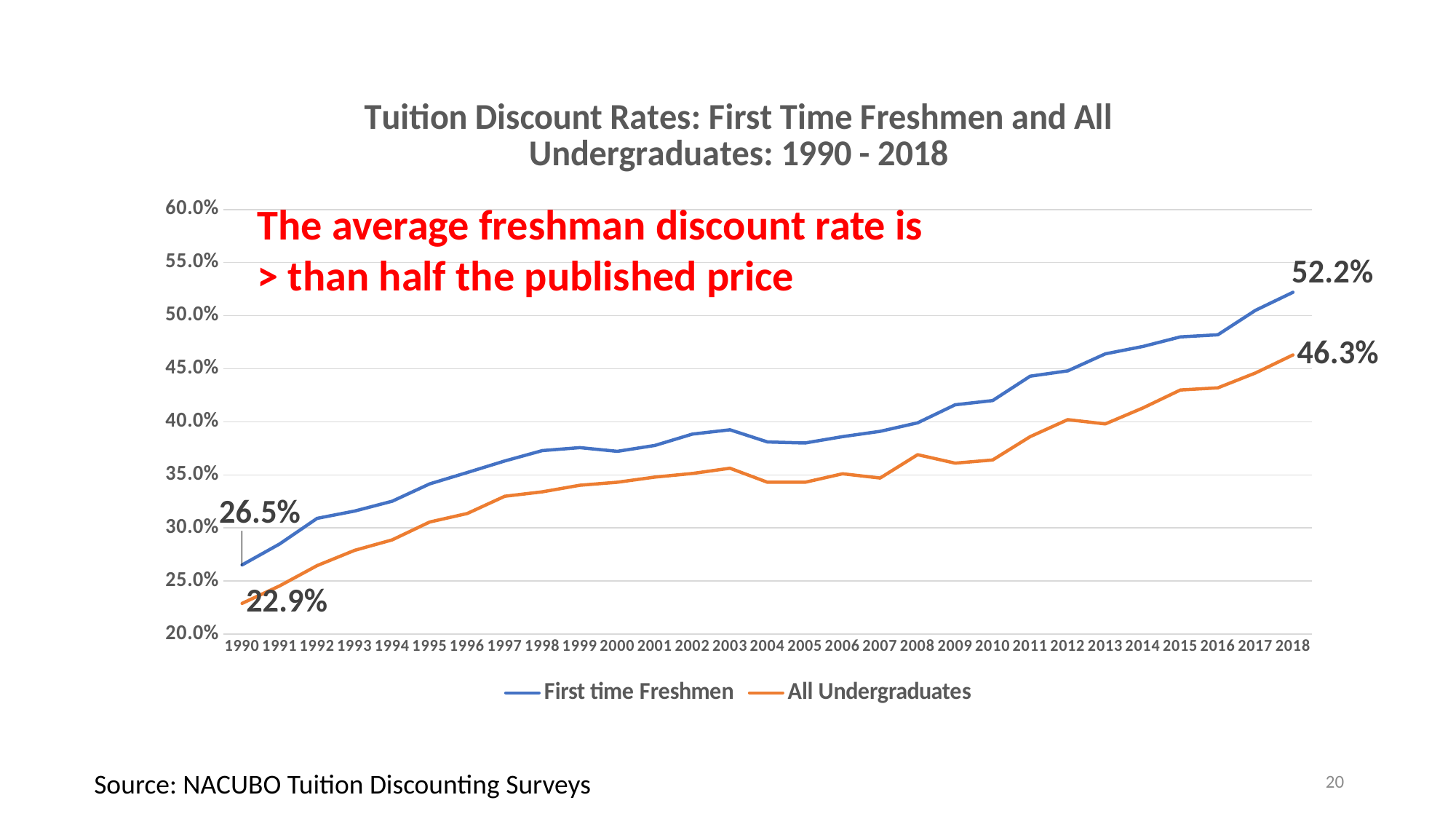
What is the tuition discount rate for All Undergraduates in 1990? 22.9% What is the tuition discount rate for First time Freshmen in 1990? 26.5% By how much did the First time Freshmen discount rate increase from 1990 to 2018? 25.7% What kind of chart is shown on the slide? line chart What is the tuition discount rate for All Undergraduates in 2018? 46.3% What is the difference between the First time Freshmen and All Undergraduates discount rates in 2018? 5.9% Do the First time Freshmen values generally rise or fall from 1990 to 2018? rise Is the value for All Undergraduates in 2010 greater or less than 40.0%? less How many years are shown on the x axis? 29 Which series has the higher value in 2018, First time Freshmen or All Undergraduates? First time Freshmen What is the tuition discount rate for First time Freshmen in 2018? 52.2% How many series does the legend list? 2